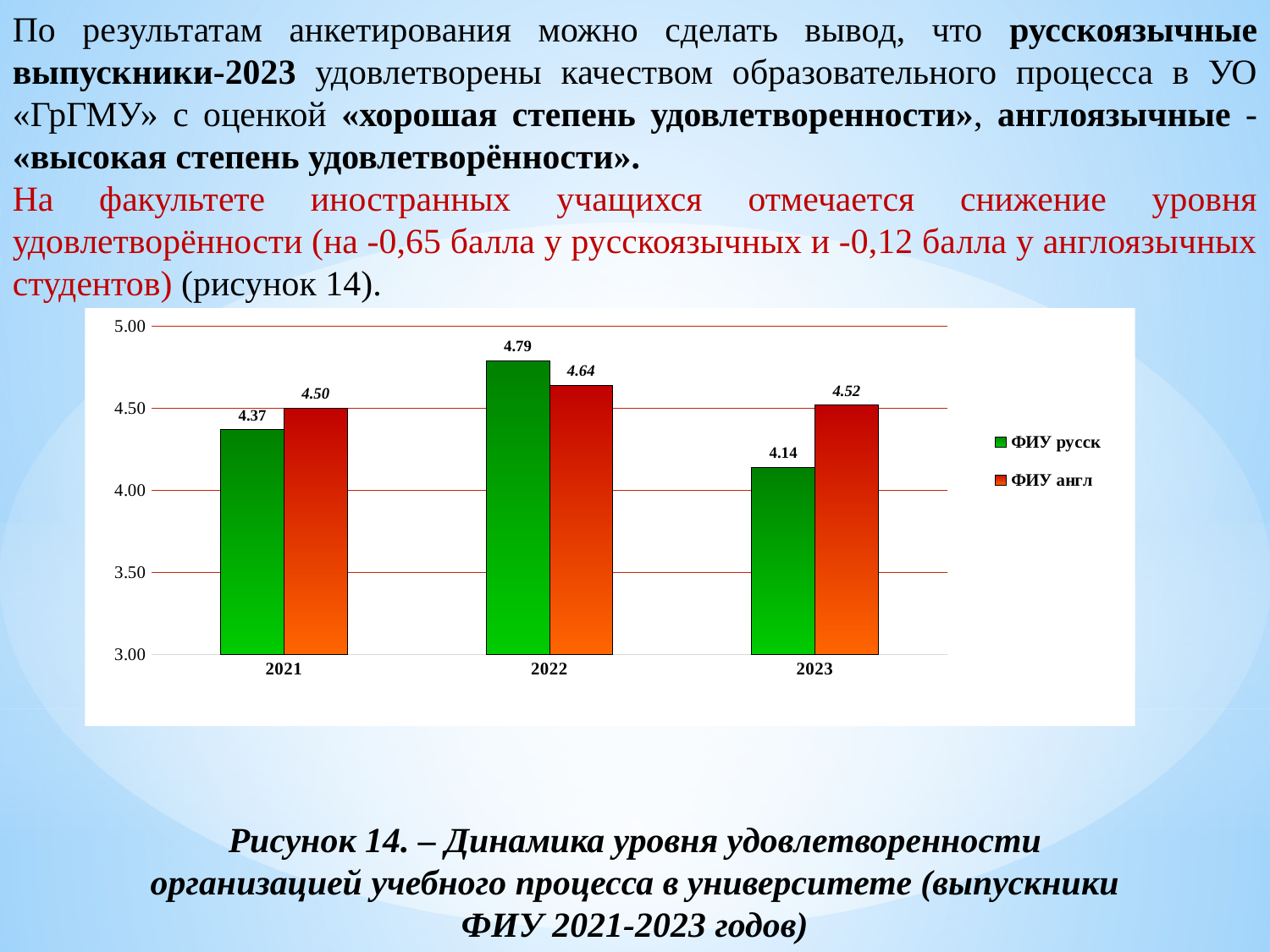
What is the value for ФИУ русск in 2021? 4.37 What is the value for ФИУ англ in 2023? 4.52 What is the value for ФИУ англ in 2022? 4.64 Which is larger in 2021: ФИУ русск or ФИУ англ? ФИУ англ What is the difference between the ФИУ русск values for 2022 and 2023? 0.65 How many series does the legend list? 2 In which year is the ФИУ русск value highest? 2022 Which colour represents ФИУ англ in the chart? orange-red In which year is the ФИУ англ value lowest? 2021 What is the value for ФИУ русск in 2023? 4.14 How many years are shown on the x axis? 3 What kind of chart is shown on the slide? bar chart